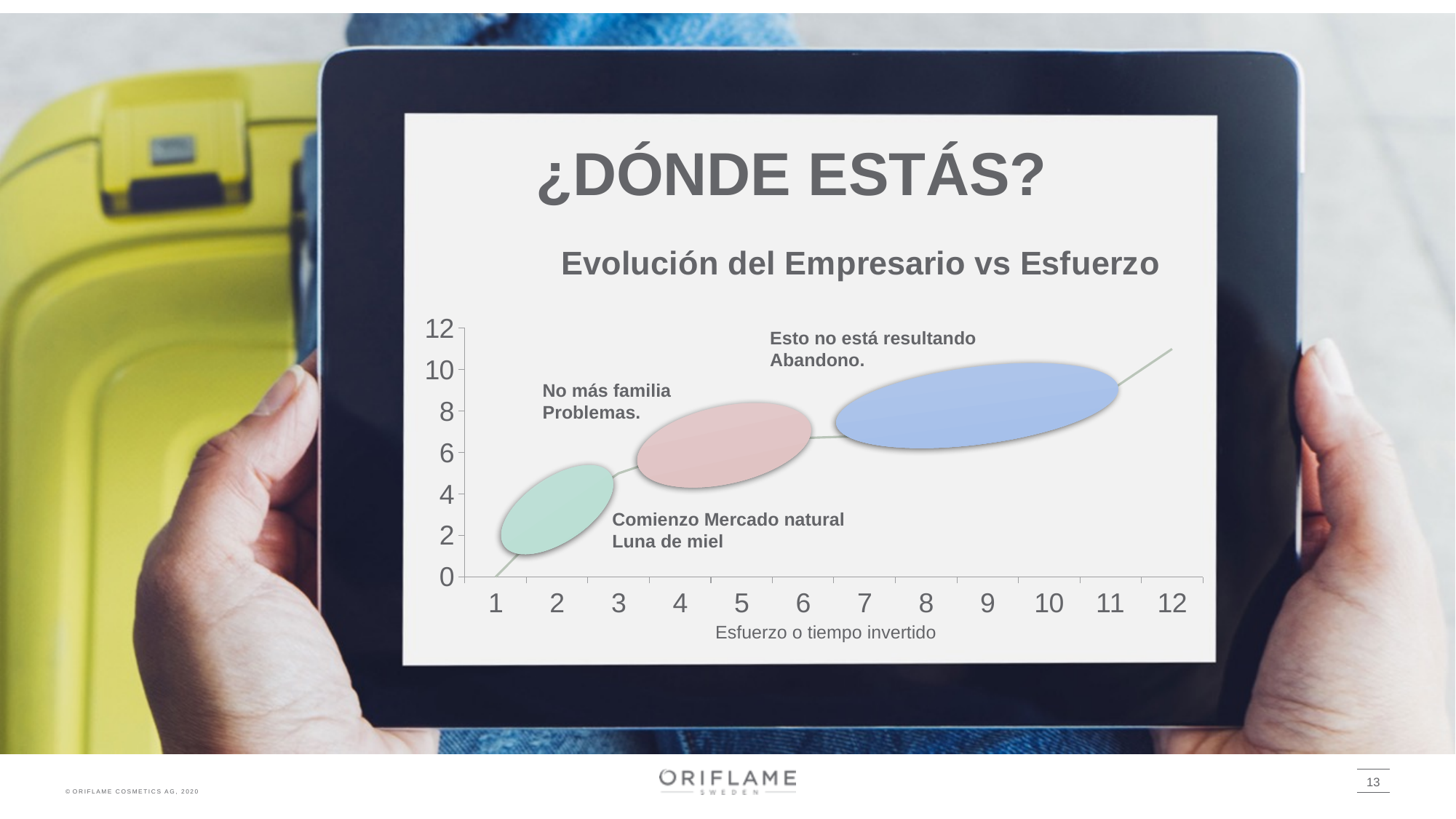
Do the values rise or fall as the x axis goes from 1 to 12? rise Which has the larger value, x = 2 or x = 10? x = 10 How many points are marked along the x axis? 12 What is the label of the x axis? Esfuerzo o tiempo invertido Is the value at x = 9 greater or less than 10? less Is the value at x = 1 greater or less than 2? less Is the value at x = 12 greater or less than 10? greater What is the title of the chart? Evolución del Empresario vs Esfuerzo What is the highest value shown on the y axis? 12 What kind of chart is shown on the slide? line chart